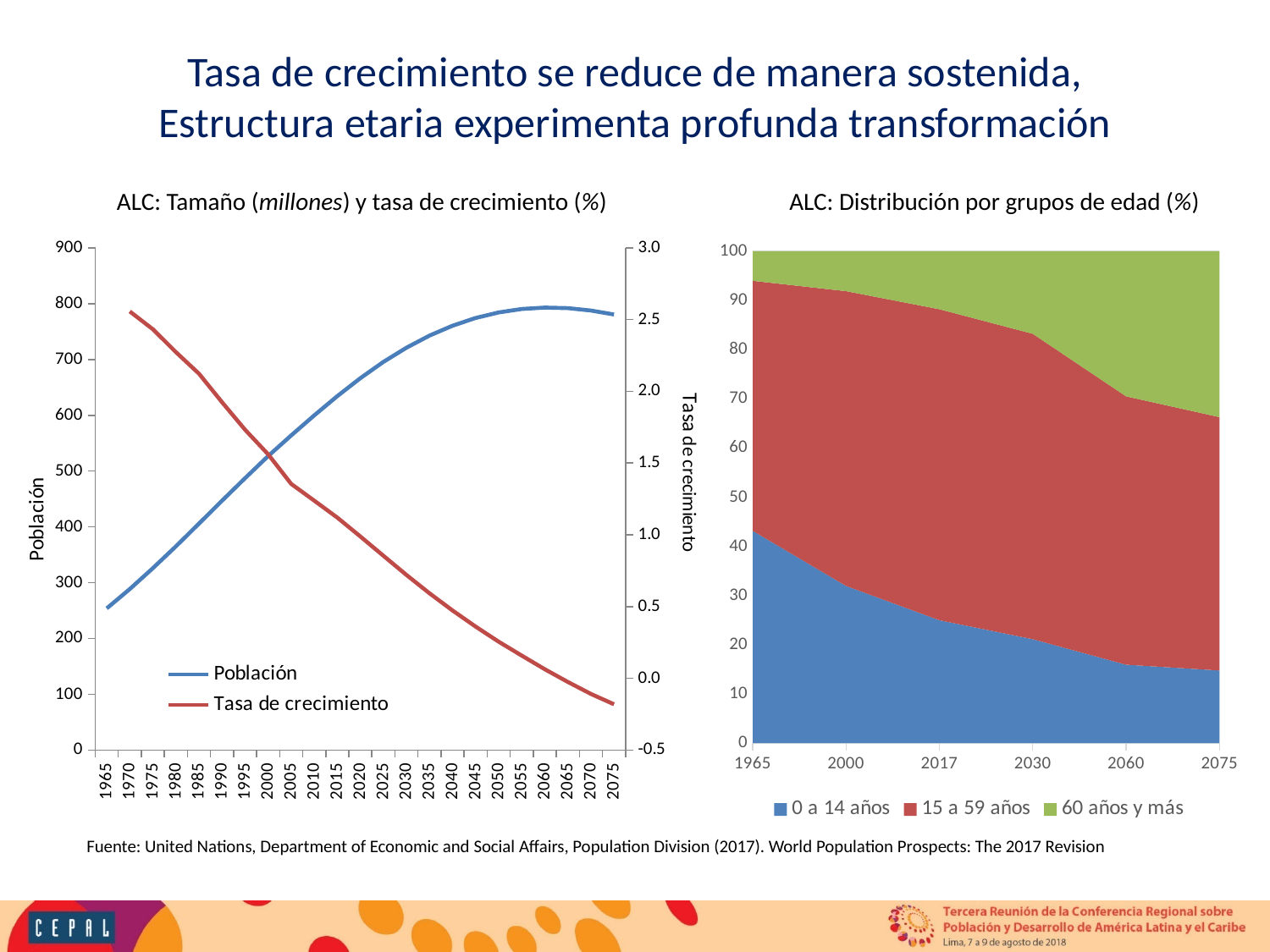
On the left chart, how many series does the legend list? 2 On the right chart, how many years are shown on the x axis? 6 On the left chart, does the Tasa de crecimiento series rise or fall from 1970 to 2075? fall On the left chart, is the Tasa de crecimiento value for 1970 greater or less than 2.0? greater On the left chart (ALC: Tamaño y tasa de crecimiento), what kind of chart is it? line chart On the left chart, is the Población value for 1965 greater or less than 300? less On the left chart, is the Tasa de crecimiento value for 2075 greater or less than 0.0? less On the right chart, how many series does the legend list? 3 On the right chart (ALC: Distribución por grupos de edad), what kind of chart is it? stacked area chart On the right chart, does the share of 0 a 14 años rise or fall from 1965 to 2075? fall